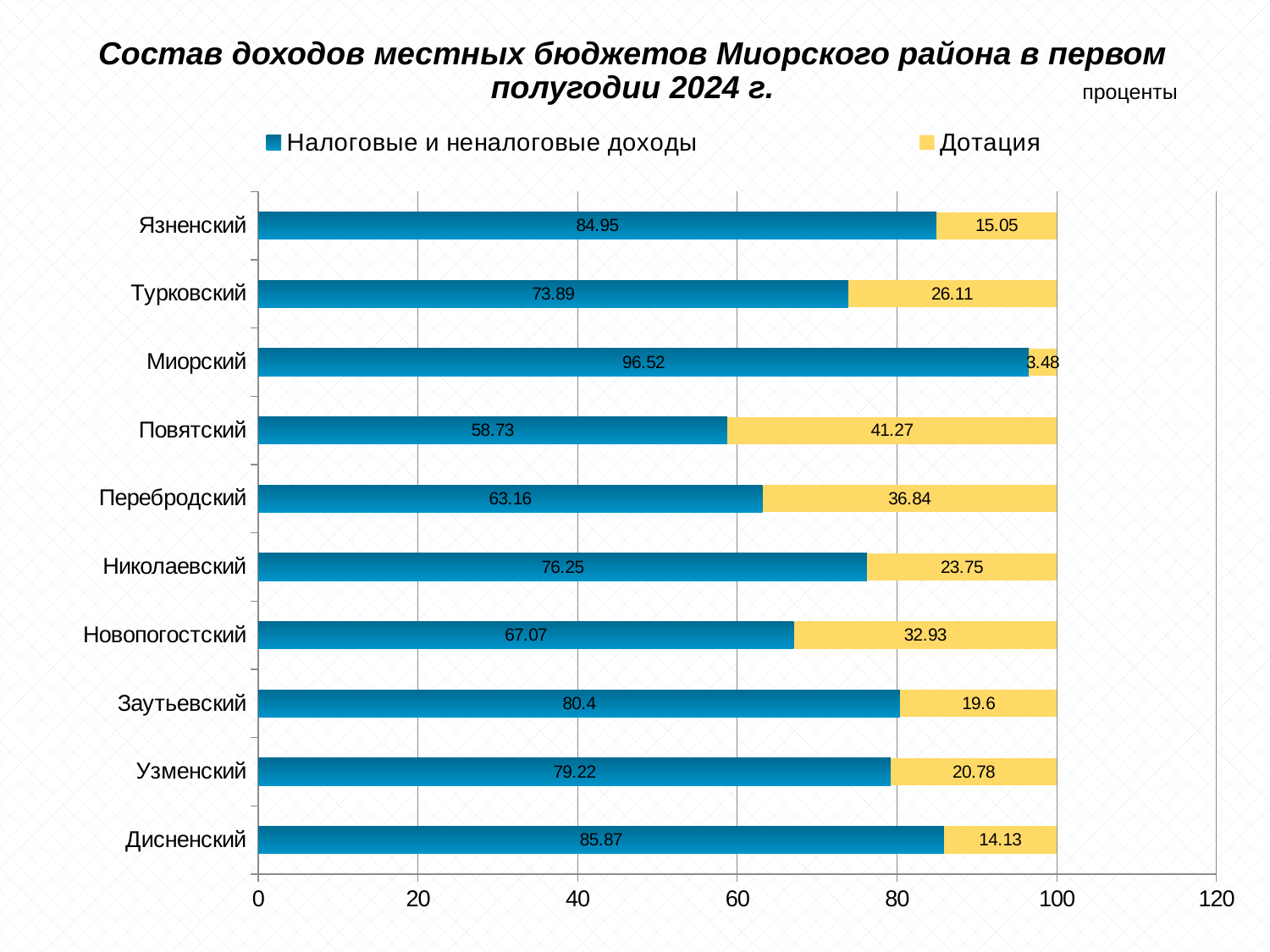
What is the value of Налоговые и неналоговые доходы for Миорский? 96.52 What kind of chart is shown on the slide? Stacked bar chart What is the value of Налоговые и неналоговые доходы for Заутьевский? 80.4 What is the total of the stacked bar for Новопогостский? 100 How many series does the legend list? 2 Which is larger: the Дотация value for Турковский or for Николаевский? Турковский Which category has the highest value of Дотация? Повятский What is the difference between the Налоговые и неналоговые доходы values for Дисненский and Язненский? 0.92 How many categories are shown on the chart? 10 Which category has the lowest value of Налоговые и неналоговые доходы? Повятский What unit is indicated in the top right corner of the chart? проценты What is the value of Дотация for Повятский? 41.27